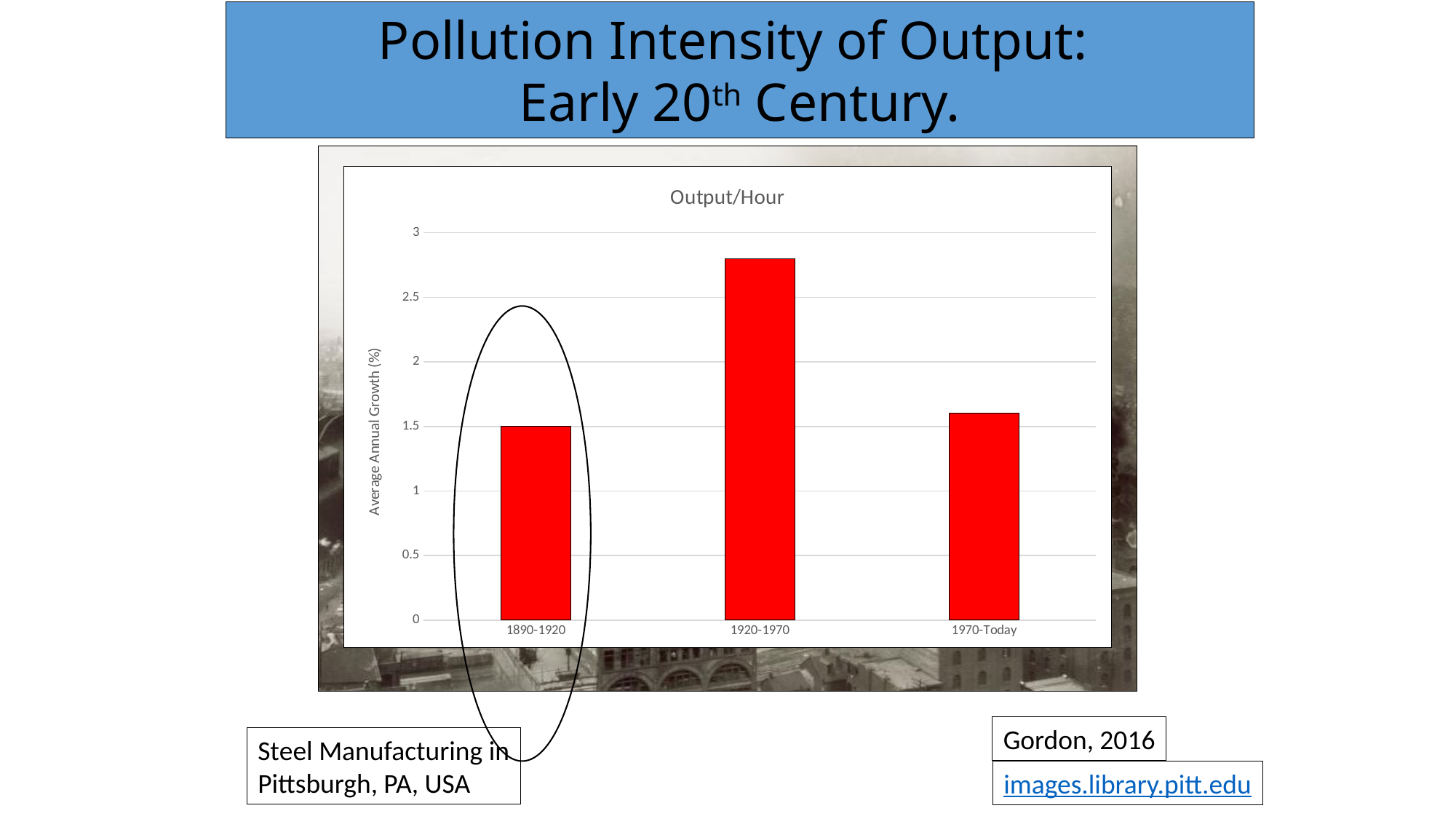
How many categories (bars) are shown in the chart? 3 Which is larger, the value for 1970-Today or the value for 1890-1920? 1970-Today Which is larger, the value for 1920-1970 or the value for 1970-Today? 1920-1970 What is the value for 1890-1920 in the chart? 1.5 What kind of chart is shown on the slide? bar chart Which period has the highest average annual growth in the chart? 1920-1970 Is the value for 1920-1970 greater or less than 2.5? greater What is the title of the chart? Output/Hour Is the value for 1970-Today greater or less than 2? less Is the value for 1920-1970 greater or less than 3? less Which period has the lowest average annual growth in the chart? 1890-1920 What is the label of the vertical axis of the chart? Average Annual Growth (%)